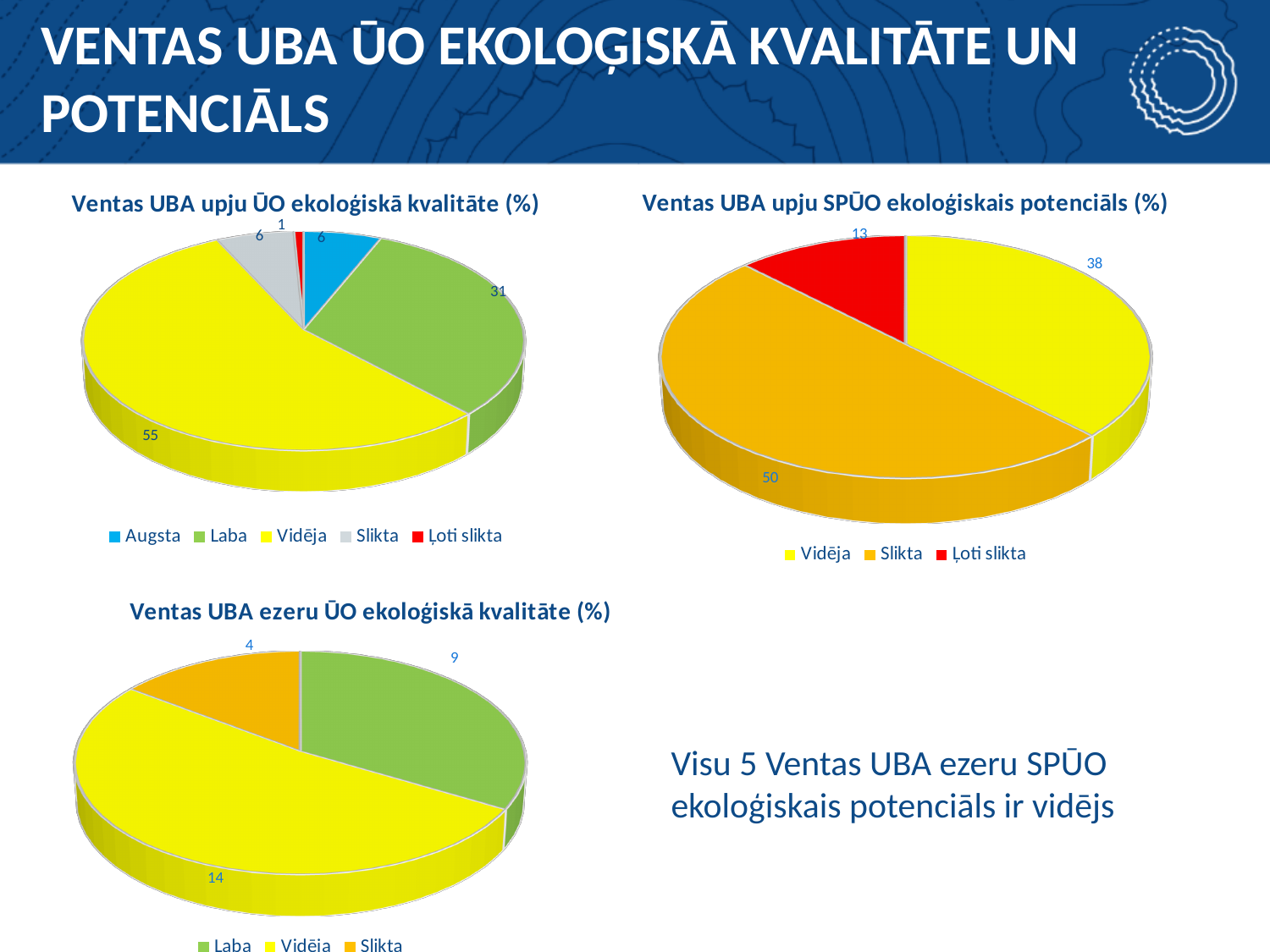
In the chart titled "Ventas UBA ezeru ŪO ekoloģiskā kvalitāte (%)", which is larger, Laba or Slikta? Laba In the chart titled "Ventas UBA upju ŪO ekoloģiskā kvalitāte (%)", what is the value for Laba? 31 In the chart titled "Ventas UBA upju SPŪO ekoloģiskais potenciāls (%)", what kind of chart is shown? Pie chart In the chart titled "Ventas UBA upju SPŪO ekoloģiskais potenciāls (%)", which category has the largest slice? Slikta In the chart titled "Ventas UBA ezeru ŪO ekoloģiskā kvalitāte (%)", what colour is the Slikta slice? Orange In the chart titled "Ventas UBA ezeru ŪO ekoloģiskā kvalitāte (%)", what is the difference between the values for Vidēja and Laba? 5 In the chart titled "Ventas UBA upju ŪO ekoloģiskā kvalitāte (%)", how many categories does the legend list? 5 In the chart titled "Ventas UBA ezeru ŪO ekoloģiskā kvalitāte (%)", what is the value for Vidēja? 14 In the chart titled "Ventas UBA upju SPŪO ekoloģiskais potenciāls (%)", what is the value for Slikta? 50 In the chart titled "Ventas UBA upju ŪO ekoloģiskā kvalitāte (%)", which category has the smallest slice? Ļoti slikta In the chart titled "Ventas UBA upju ŪO ekoloģiskā kvalitāte (%)", what is the value for Vidēja? 55 In the chart titled "Ventas UBA upju SPŪO ekoloģiskais potenciāls (%)", what is the difference between the values for Slikta and Vidēja? 12